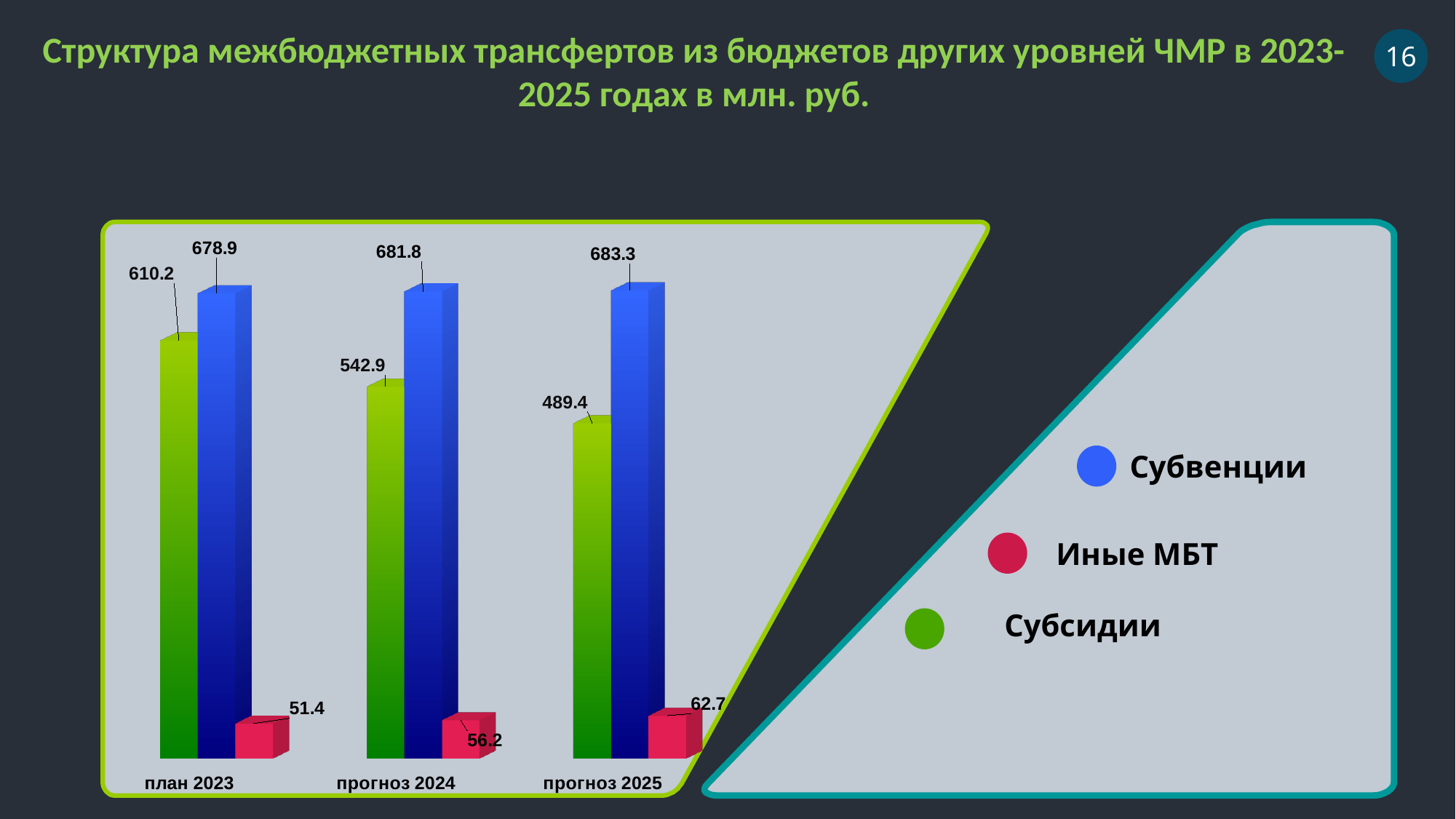
How many series does the legend list? 3 What is the value of Субсидии for план 2023? 610.2 Do the values of Субсидии rise or fall from план 2023 to прогноз 2025? fall In which category is the value of Субсидии the lowest? прогноз 2025 What kind of chart is shown on the slide? bar chart What is the value of Иные МБТ for прогноз 2024? 56.2 How many categories are shown on the x axis? 3 Which colour represents Иные МБТ in the legend? red Which is larger for план 2023: Субсидии or Субвенции? Субвенции In which category is the value of Иные МБТ the highest? прогноз 2025 What is the value of Субвенции for прогноз 2025? 683.3 What is the difference between Субвенции and Субсидии for прогноз 2024? 138.9